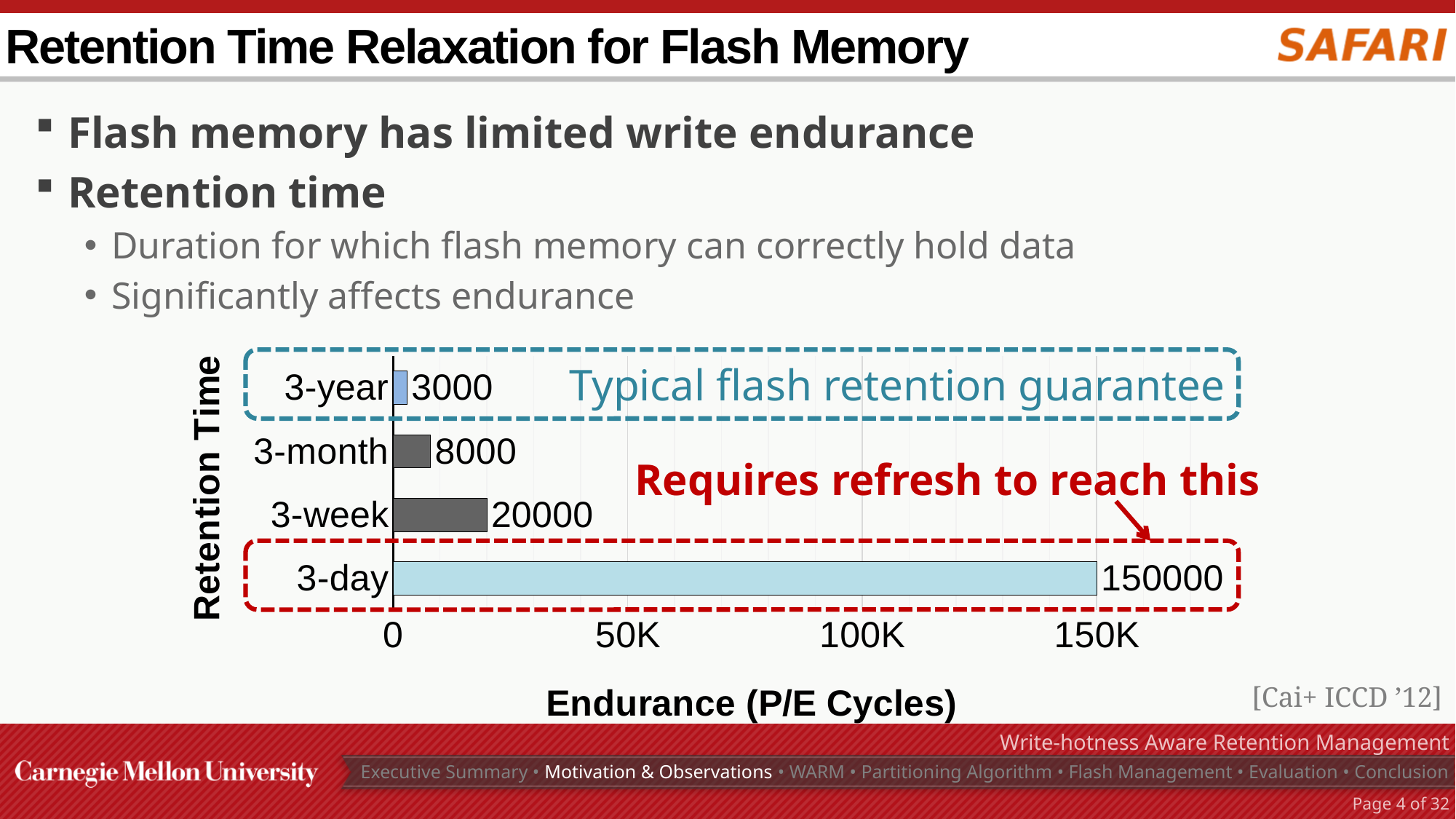
What is the endurance value for the 3-day retention time? 150000 What is the endurance value for the 3-month retention time? 8000 What is the endurance value for the 3-year retention time? 3000 How many retention time categories are shown in the chart? 4 What is the difference in endurance between the 3-month and 3-year retention times? 5000 What is the endurance value for the 3-week retention time? 20000 What kind of chart is shown on the slide? bar chart Which retention time has the highest endurance? 3-day Which retention time has the lowest endurance? 3-year What is the label of the horizontal axis of the chart? Endurance (P/E Cycles) What is the difference in endurance between the 3-day and 3-week retention times? 130000 Which has a larger endurance value, 3-week or 3-month? 3-week